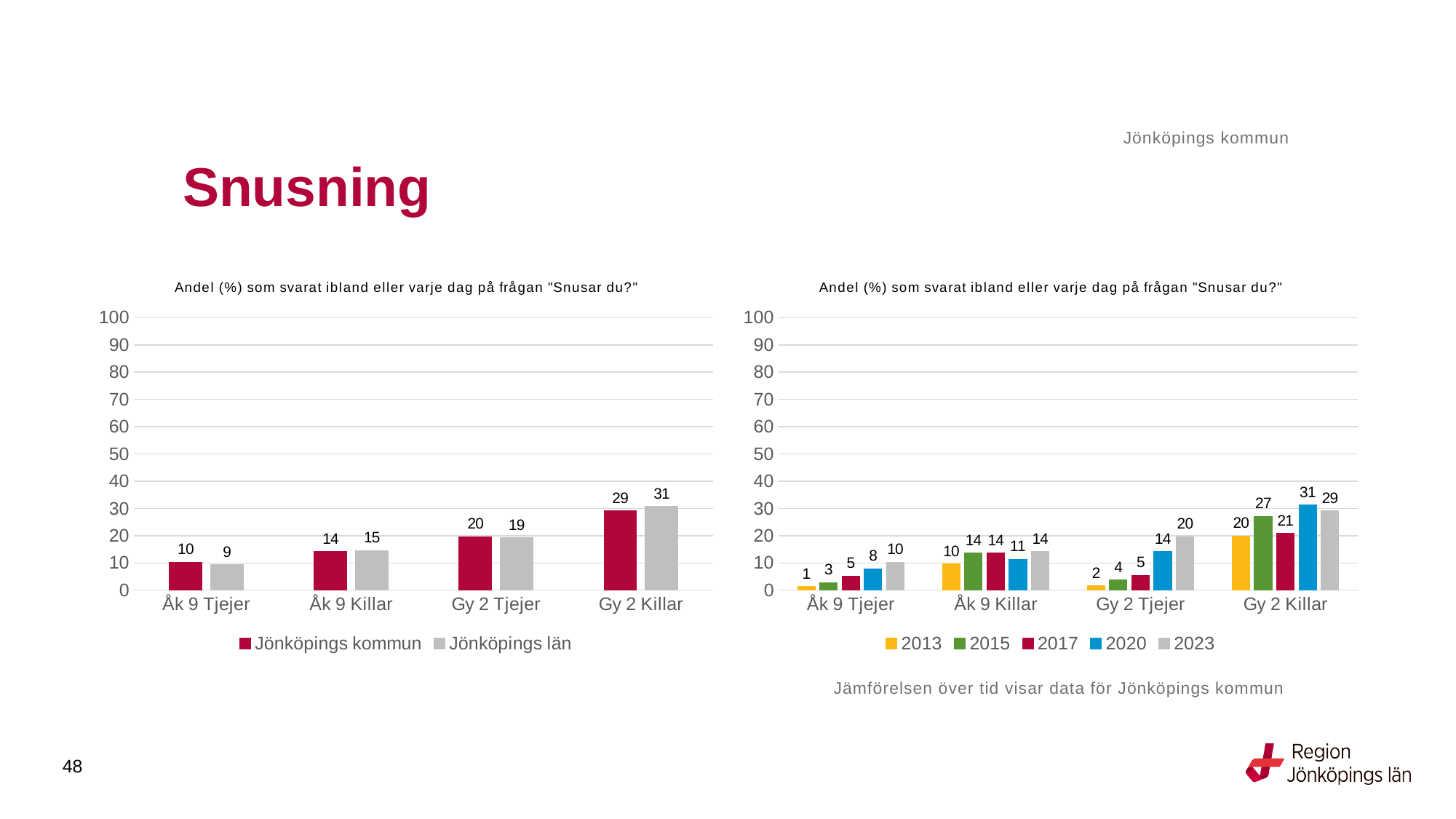
In the left chart, which category has the highest value for Jönköpings län? Gy 2 Killar In the left chart, what is the difference between Jönköpings län and Jönköpings kommun for Gy 2 Killar? 2 In the right chart, how many series does the legend list? 5 In the left chart, what is the value for Jönköpings län for Åk 9 Tjejer? 9 In the right chart, which year has the lowest value for Gy 2 Tjejer? 2013 In the left chart, what is the value for Jönköpings kommun for Gy 2 Killar? 29 In the right chart, what is the value for 2013 for Åk 9 Tjejer? 1 In the right chart, what is the value for 2020 for Gy 2 Killar? 31 In the right chart, which is larger for Åk 9 Killar: the 2013 value or the 2023 value? 2023 In the right chart, what is the difference between the 2023 and 2013 values for Gy 2 Tjejer? 18 In the left chart, how many series does the legend list? 2 What kind of chart is the left chart? Bar chart